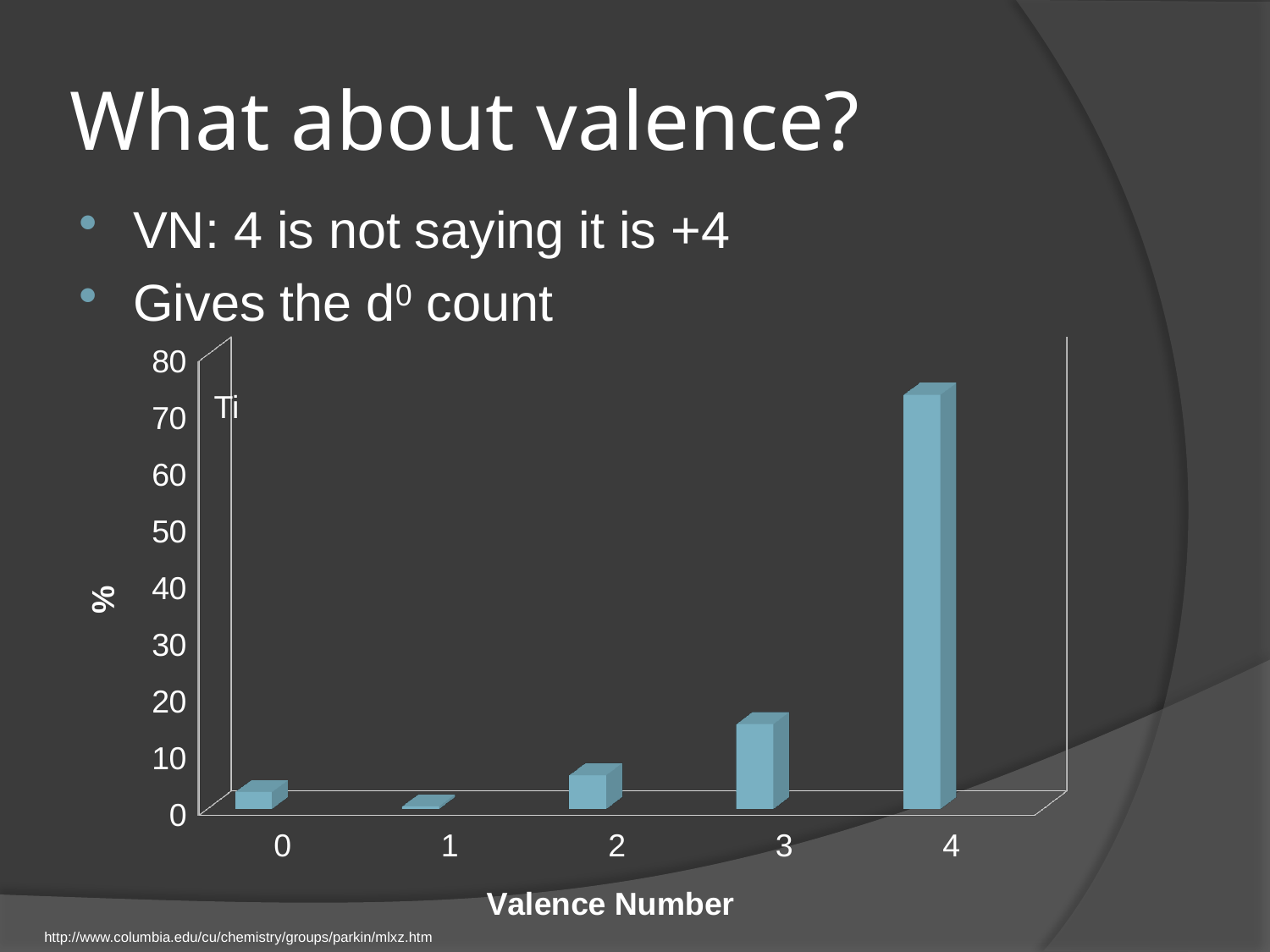
How many valence number categories are shown on the x axis? 5 What is the title of the x axis of the chart? Valence Number What kind of chart is shown on the slide? bar chart Is the value for valence number 4 greater or less than 70? greater Is the value for valence number 3 greater or less than 20? less Which valence number has the lowest percentage? 1 What element label appears in the top-left corner of the chart's plot area? Ti Which has a larger percentage, valence number 3 or valence number 2? 3 Which has a larger percentage, valence number 0 or valence number 4? 4 Is the value for valence number 4 greater or less than 80? less Which valence number has the highest percentage? 4